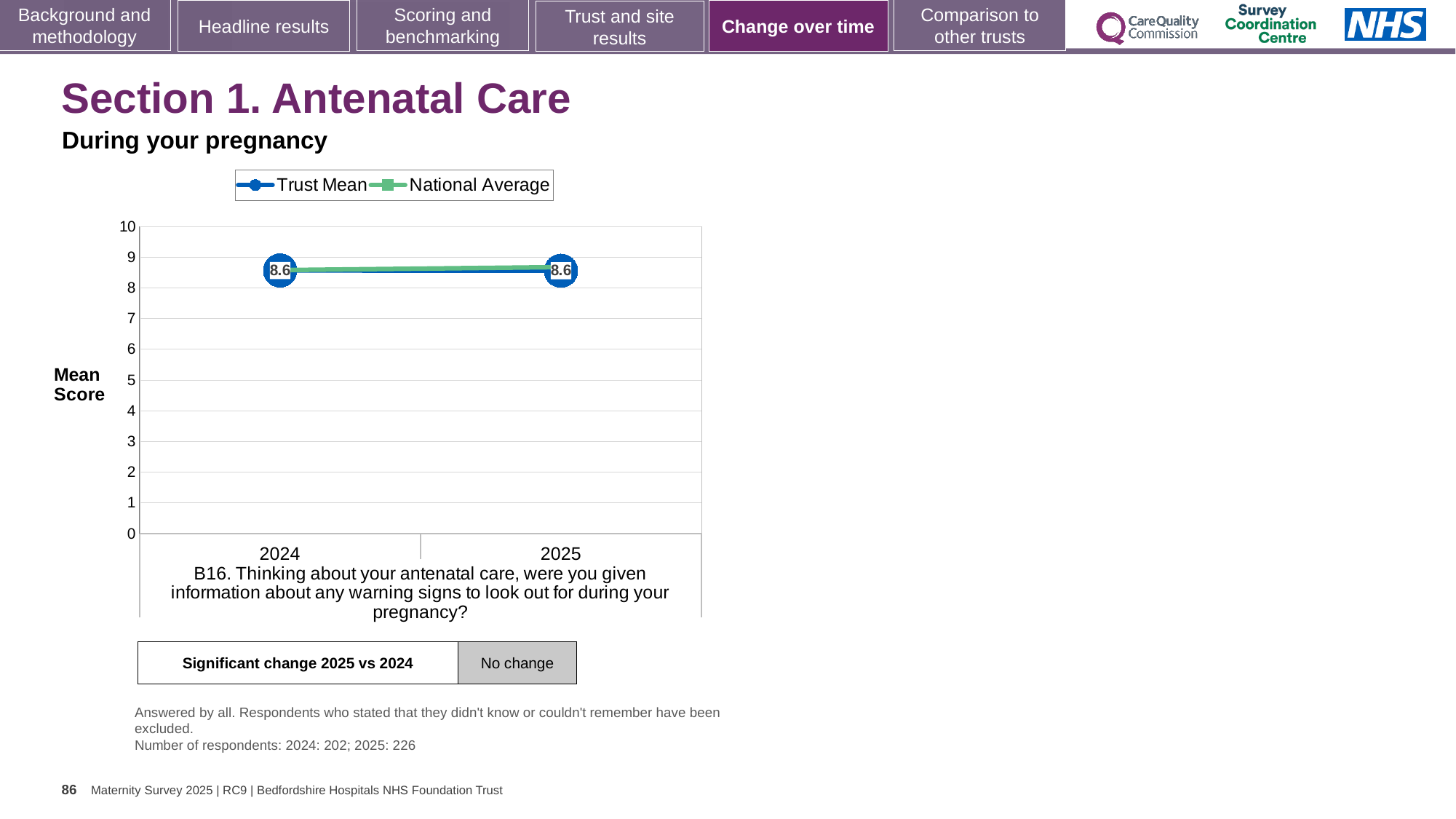
Is the National Average value for 2024 greater or less than 9? less What is the label on the y axis of the chart? Mean Score What kind of chart is shown on the slide? line chart Is the National Average value for 2025 greater or less than 8? greater What is the difference between the Trust Mean in 2025 and the Trust Mean in 2024? 0 What is the Trust Mean value for 2024? 8.6 Is the Trust Mean value for 2024 greater or less than 5? greater What is the Trust Mean value for 2025? 8.6 How many series does the chart legend list? 2 How many years are plotted on the x axis of the chart? 2 Which two series are listed in the chart legend? Trust Mean and National Average Does the Trust Mean rise, fall or stay the same from 2024 to 2025? stays the same